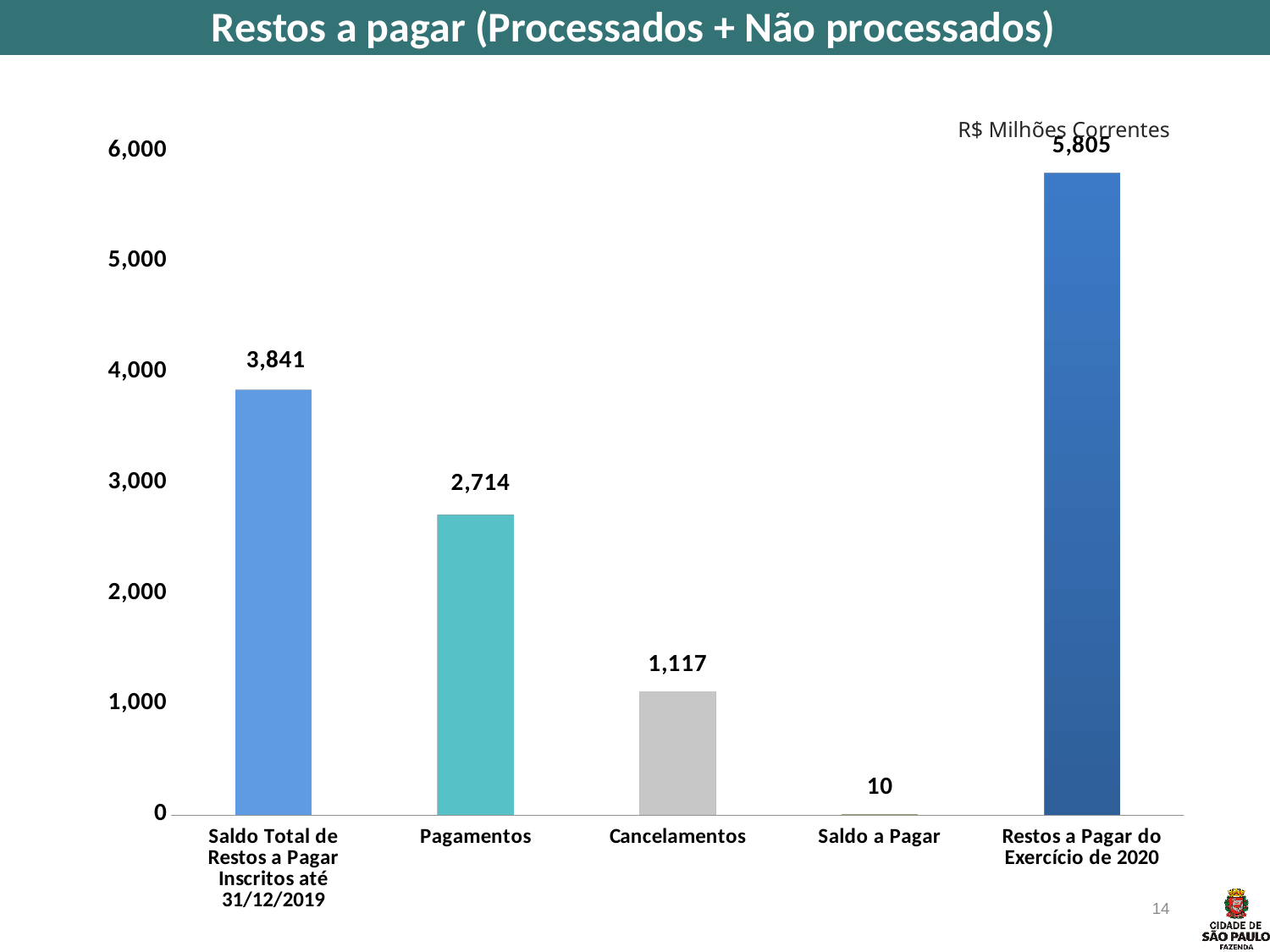
How many categories are shown on the x axis? 5 What is the difference between Saldo Total de Restos a Pagar Inscritos até 31/12/2019 and Pagamentos? 1,127 What is the value for Restos a Pagar do Exercício de 2020? 5,805 What is the value for Saldo a Pagar? 10 What kind of chart is shown on the slide? bar chart Is the value for Saldo Total de Restos a Pagar Inscritos até 31/12/2019 greater or less than 4,000? less What unit is indicated in the note at the top right of the chart? R$ Milhões Correntes What is the value for Cancelamentos? 1,117 Which category has the highest value? Restos a Pagar do Exercício de 2020 Which category has the lowest value? Saldo a Pagar What is the value for Pagamentos? 2,714 Which is larger, Pagamentos or Cancelamentos? Pagamentos